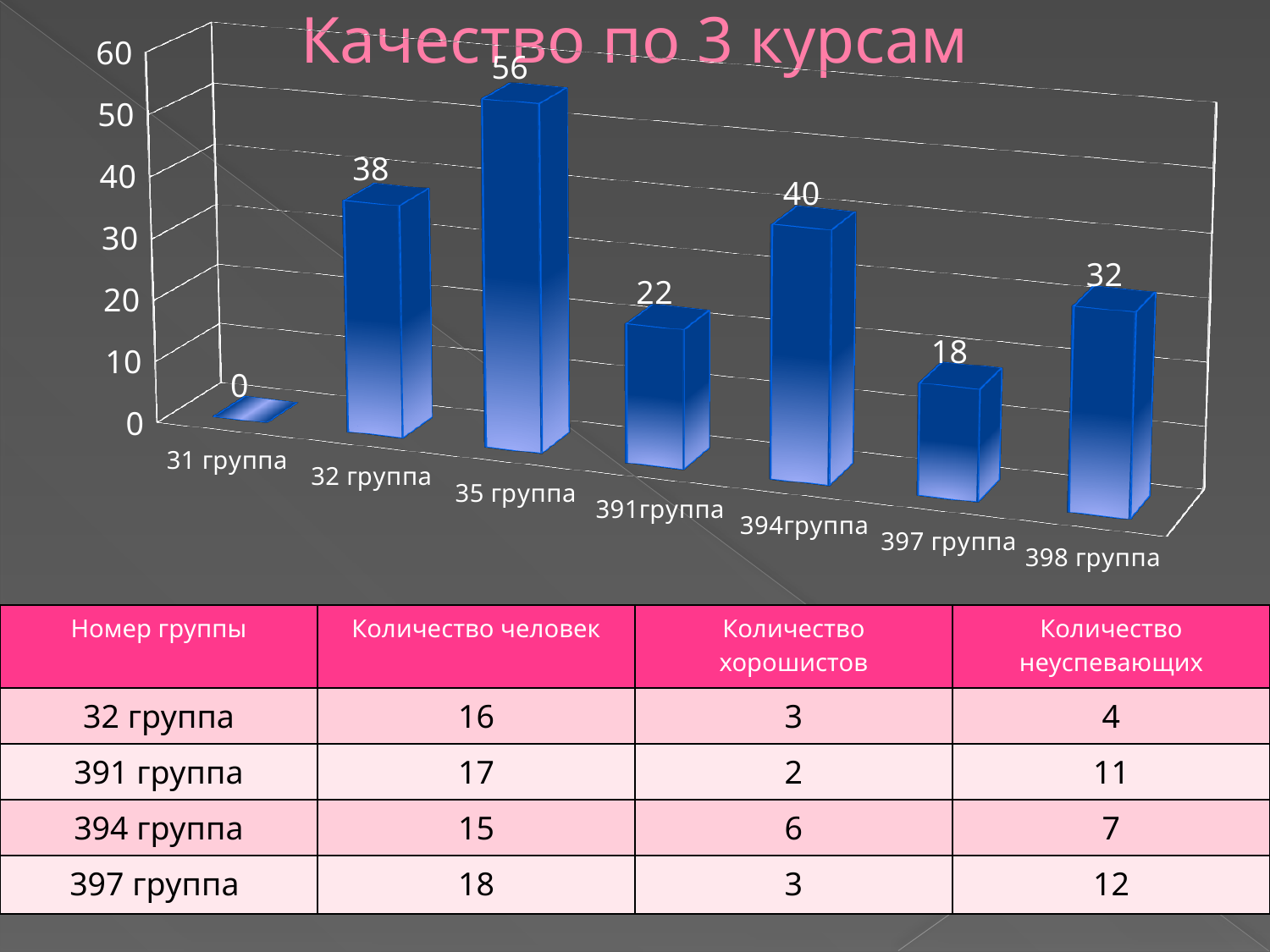
Which is larger, the value for 394 группа or the value for 398 группа? 394 группа Which group has the lowest value? 31 группа What is the difference between the values for 394 группа and 391 группа? 18 What is the value for 398 группа? 32 What kind of chart is shown on the slide? bar chart What is the value for 35 группа? 56 What is the difference between the values for 35 группа and 32 группа? 18 How many groups are shown on the chart? 7 What is the title of the chart? Качество по 3 курсам Which group has the highest value? 35 группа Is the value for 32 группа greater or less than 30? greater What is the value for 397 группа? 18